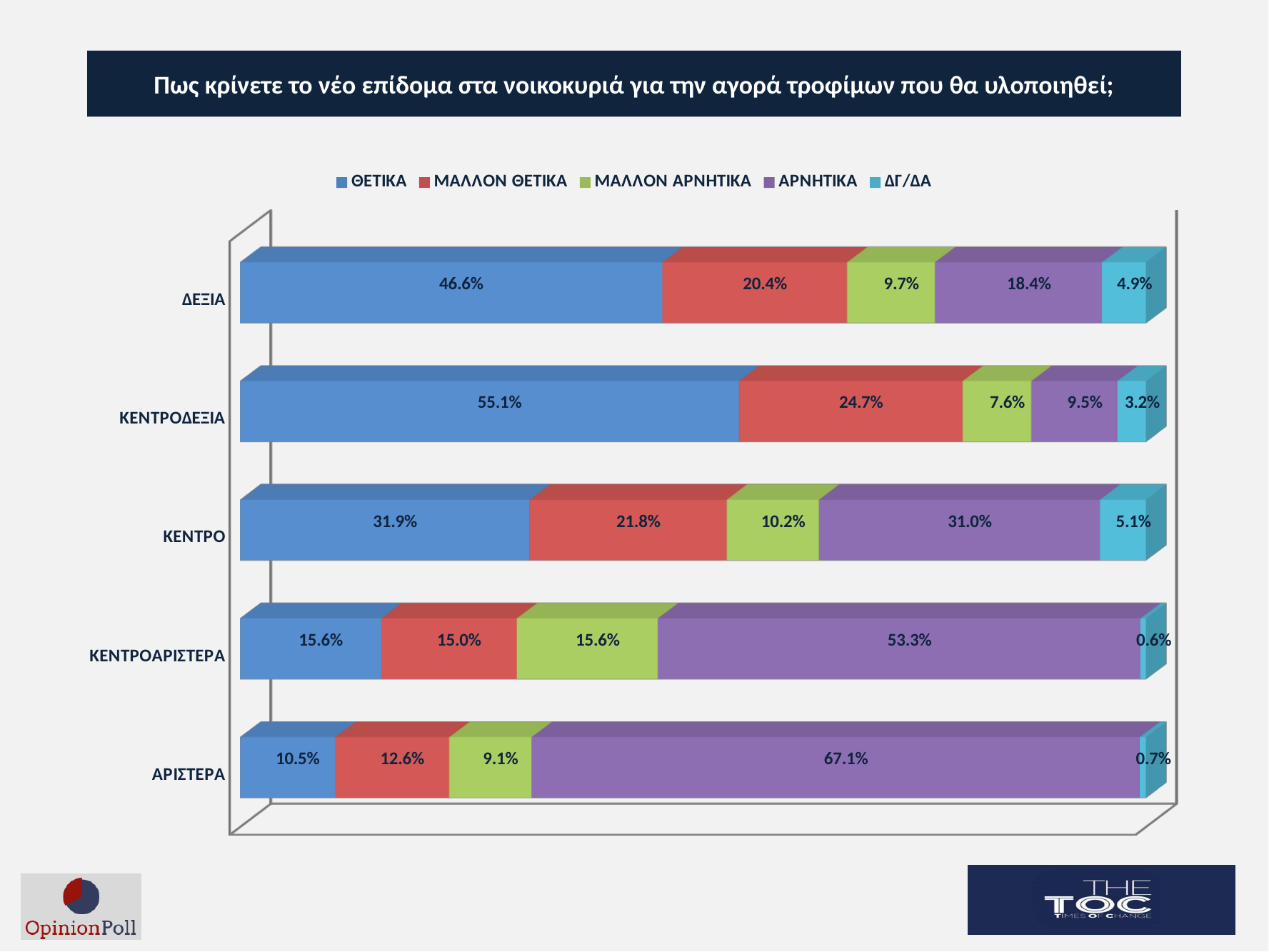
What type of chart is shown on the slide? Stacked bar chart Which category has the highest ΘΕΤΙΚΑ value? ΚΕΝΤΡΟΔΕΞΙΑ What is the ΜΑΛΛΟΝ ΑΡΝΗΤΙΚΑ value for ΚΕΝΤΡΟΑΡΙΣΤΕΡΑ? 15.6% How many categories (political groups) are shown on the chart? 5 What is the ΑΡΝΗΤΙΚΑ value for ΑΡΙΣΤΕΡΑ? 67.1% What is the ΘΕΤΙΚΑ value for ΚΕΝΤΡΟΔΕΞΙΑ? 55.1% Which category has the lowest ΑΡΝΗΤΙΚΑ value? ΚΕΝΤΡΟΔΕΞΙΑ What is the difference between the ΘΕΤΙΚΑ values for ΚΕΝΤΡΟΔΕΞΙΑ and ΔΕΞΙΑ? 8.5 percentage points What is the ΔΓ/ΔΑ value for ΚΕΝΤΡΟ? 5.1% What is the total of the stacked bar for ΔΕΞΙΑ? 100.0% Which is larger: the ΜΑΛΛΟΝ ΘΕΤΙΚΑ value for ΔΕΞΙΑ or for ΚΕΝΤΡΟ? ΚΕΝΤΡΟ How many series does the legend list? 5